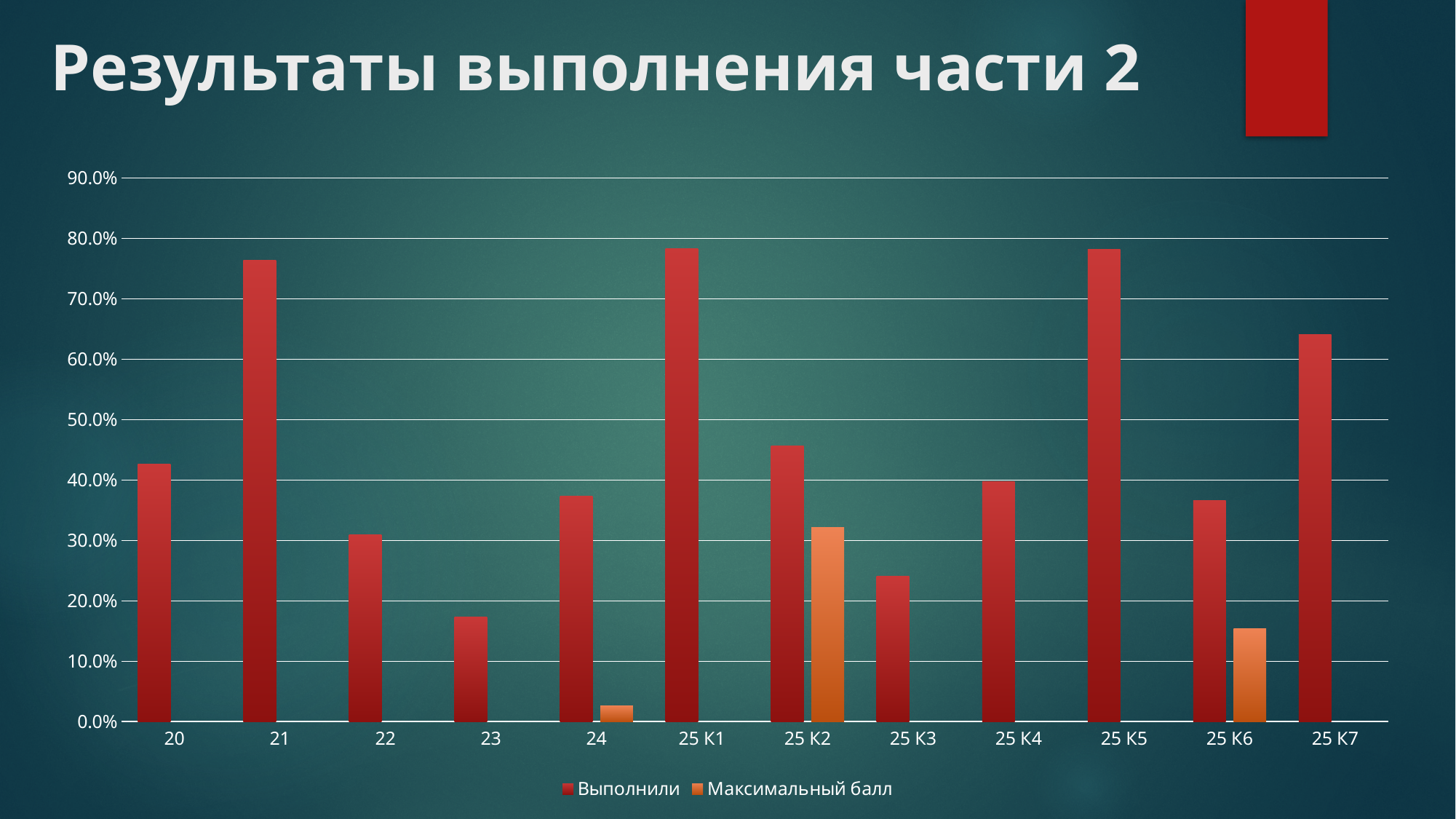
What kind of chart is shown on the slide? bar chart Is the value for Выполнили at category 23 greater or less than 20.0%? less How many categories are shown on the x axis of the chart? 12 What is the title of the slide containing the chart? Результаты выполнения части 2 For the series Выполнили, which is larger: the value for category 20 or for category 25 К2? 25 К2 Is the value for Максимальный балл at category 25 К6 greater or less than 20.0%? less How many series does the chart legend list? 2 Which category has the lowest value for the series Выполнили? 23 Which series is shown in orange in the chart? Максимальный балл Is the value for Выполнили at category 25 К7 greater or less than 60.0%? greater Which category has the highest value for the series Максимальный балл? 25 К2